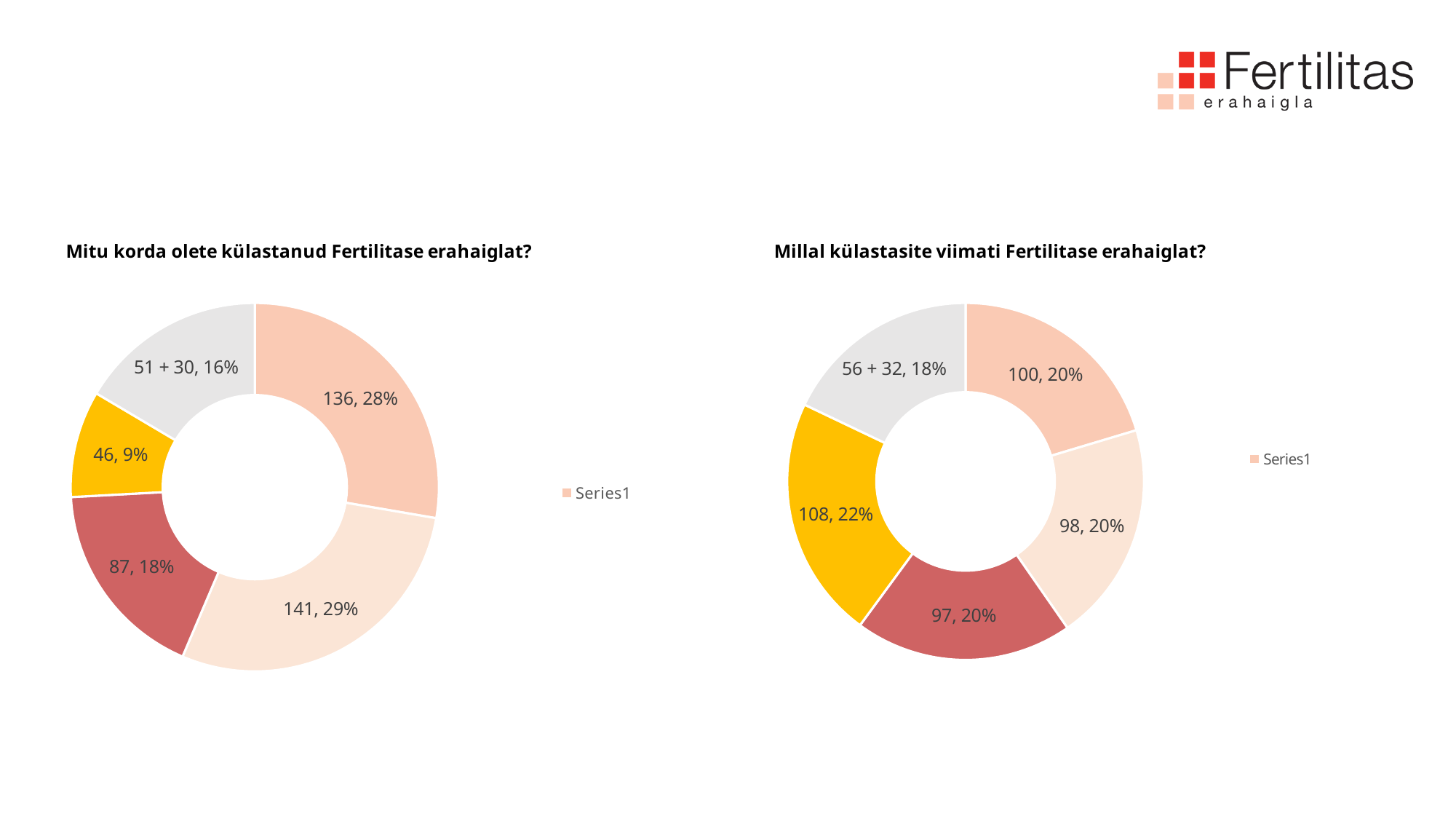
In the right chart ("Millal külastasite viimati Fertilitase erahaiglat?"), which slice has the largest share? 108, 22% In the left chart ("Mitu korda olete külastanud Fertilitase erahaiglat?"), what value is shown on the yellow slice? 46 In the left chart ("Mitu korda olete külastanud Fertilitase erahaiglat?"), what is the difference between the slice labelled 141 and the slice labelled 136? 5 In the left chart ("Mitu korda olete külastanud Fertilitase erahaiglat?"), what percentage share does the red slice have? 18% In the left chart ("Mitu korda olete külastanud Fertilitase erahaiglat?"), which slice has the smallest value? 46, 9% How many series does the legend of the right chart ("Millal külastasite viimati Fertilitase erahaiglat?") list? 1 What kind of chart is shown under the title "Mitu korda olete külastanud Fertilitase erahaiglat?"? Doughnut chart In the left chart ("Mitu korda olete külastanud Fertilitase erahaiglat?"), which is larger: the red slice or the yellow slice? The red slice How many slices does the left chart ("Mitu korda olete külastanud Fertilitase erahaiglat?") have? 5 In the left chart ("Mitu korda olete külastanud Fertilitase erahaiglat?"), which slice has the largest value? 141, 29% In the right chart ("Millal külastasite viimati Fertilitase erahaiglat?"), what value is shown on the yellow slice? 108 In the right chart ("Millal külastasite viimati Fertilitase erahaiglat?"), what label is shown on the grey slice? 56 + 32, 18%